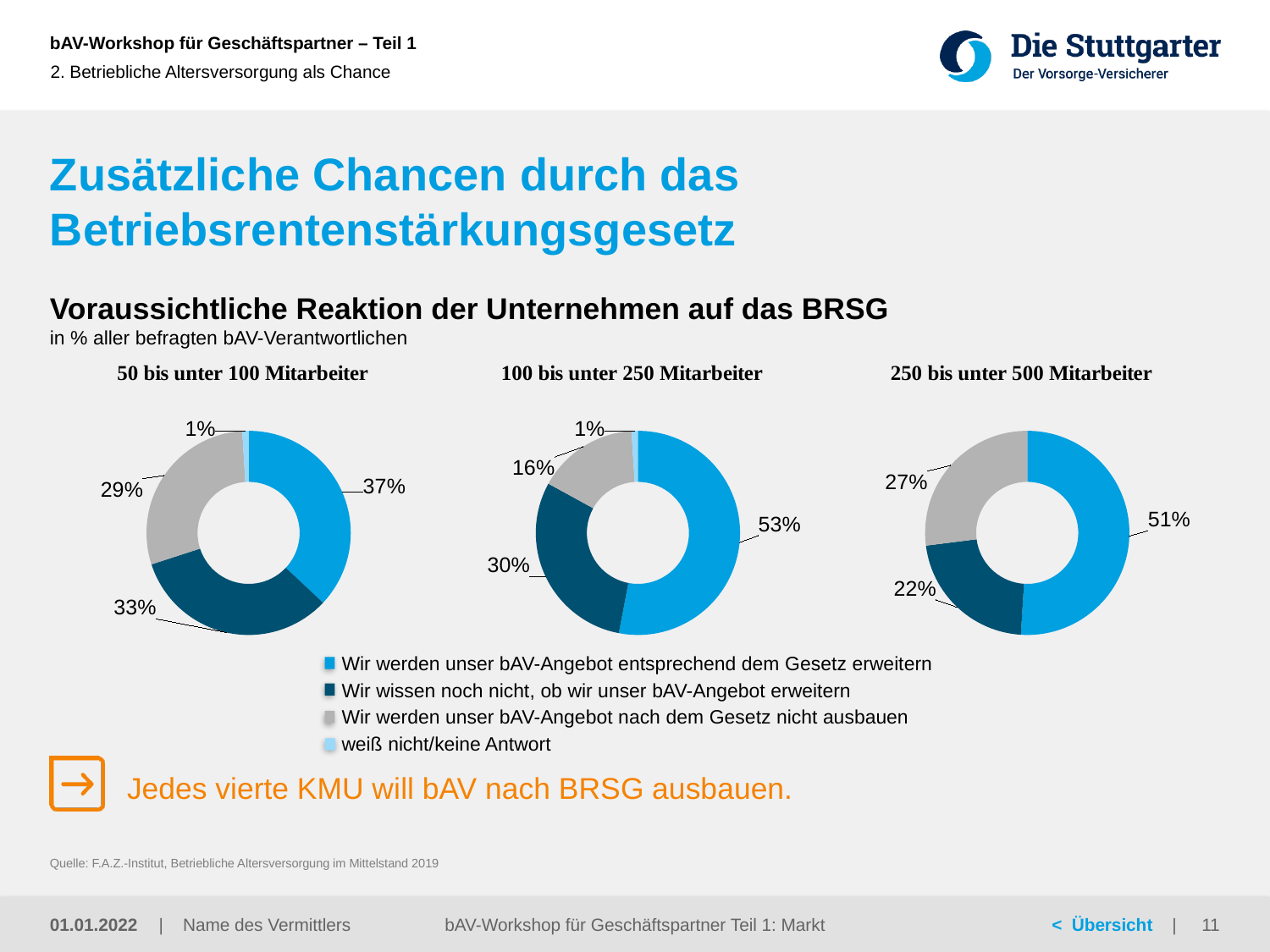
How many response categories does the legend list for the charts? 4 In the '250 bis unter 500 Mitarbeiter' chart, what is the difference in percentage points between the 'erweitern' share and the 'Wir wissen noch nicht' share? 29 percentage points In the '50 bis unter 100 Mitarbeiter' chart, what is the difference in percentage points between the 'Wir wissen noch nicht' share and the 'nicht ausbauen' share? 4 percentage points In the '100 bis unter 250 Mitarbeiter' chart, what share of respondents answered 'weiß nicht/keine Antwort'? 1% In the '100 bis unter 250 Mitarbeiter' chart, what share of respondents do not yet know whether they will expand their bAV offering (Wir wissen noch nicht)? 30% In the '100 bis unter 250 Mitarbeiter' chart, which response has the largest share? Wir werden unser bAV-Angebot entsprechend dem Gesetz erweitern How many donut charts are shown on the slide? 3 What type of chart is used to show the expected reaction of companies to the BRSG? Donut (pie) chart In the '250 bis unter 500 Mitarbeiter' chart, what share of respondents say they will not expand their bAV offering after the law (nicht ausbauen)? 27% In the '50 bis unter 100 Mitarbeiter' chart, what share of respondents say they will expand their bAV offering according to the law (Wir werden unser bAV-Angebot entsprechend dem Gesetz erweitern)? 37% Which chart shows a larger share for 'Wir werden unser bAV-Angebot entsprechend dem Gesetz erweitern': '100 bis unter 250 Mitarbeiter' or '250 bis unter 500 Mitarbeiter'? 100 bis unter 250 Mitarbeiter In the '50 bis unter 100 Mitarbeiter' chart, which response has the smallest share? weiß nicht/keine Antwort